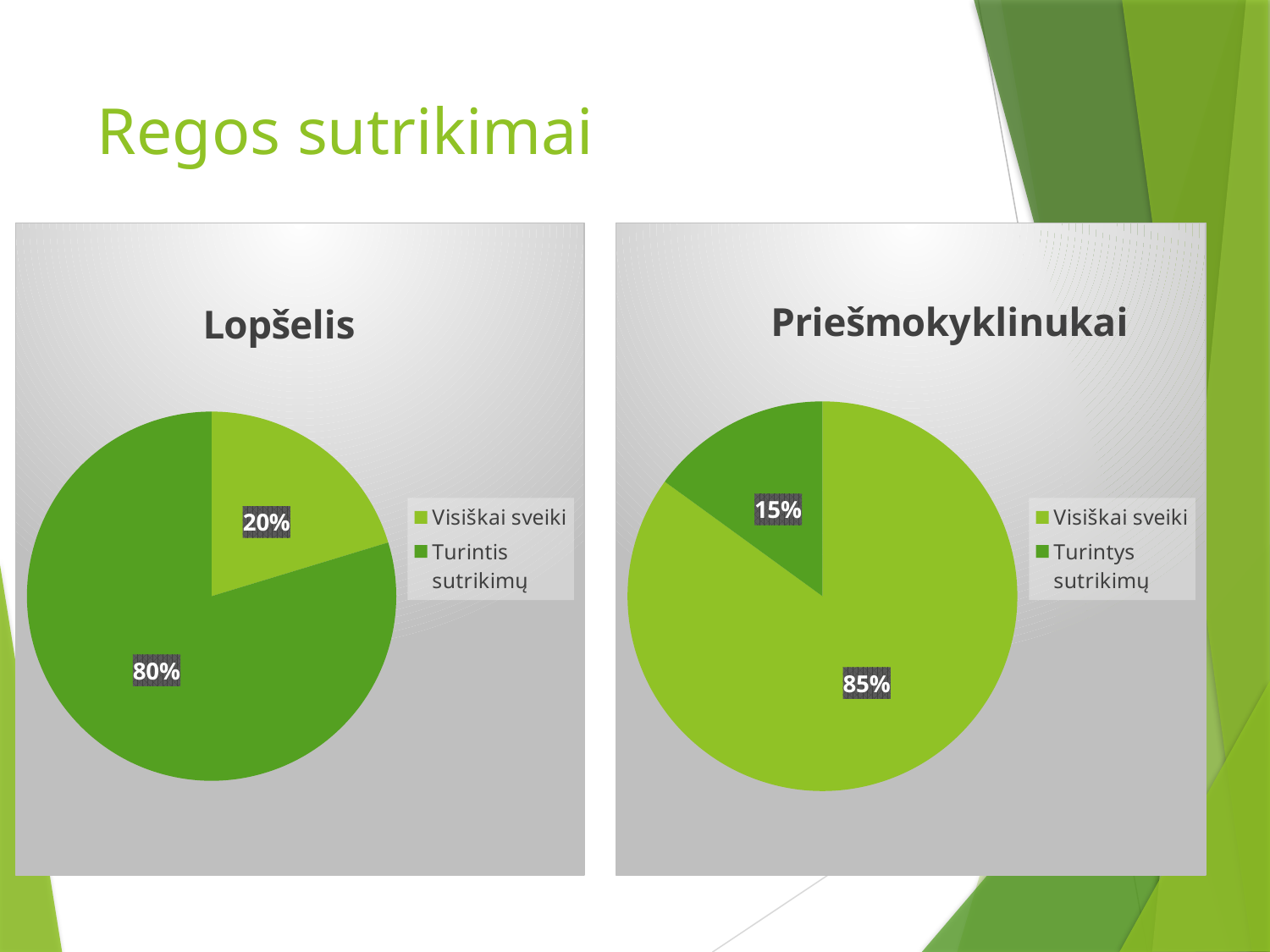
In the 'Priešmokyklinukai' chart, what percentage is shown for 'Turintys sutrikimų'? 15% Which is larger: 'Visiškai sveiki' in the 'Lopšelis' chart or 'Visiškai sveiki' in the 'Priešmokyklinukai' chart? Priešmokyklinukai What is the title of the slide? Regos sutrikimai How many slices does the 'Priešmokyklinukai' pie chart have? 2 What type of chart is the 'Lopšelis' chart? Pie chart In the 'Priešmokyklinukai' chart, which category has the smallest slice? Turintys sutrikimų In the 'Priešmokyklinukai' chart, what is the difference between the 'Visiškai sveiki' and 'Turintys sutrikimų' percentages? 70% In the 'Priešmokyklinukai' chart, what percentage is shown for 'Visiškai sveiki'? 85% In the 'Lopšelis' chart, what percentage is shown for 'Visiškai sveiki'? 20% In the 'Lopšelis' chart, which category has the largest slice? Turintis sutrikimų In the 'Lopšelis' chart, what percentage is shown for 'Turintis sutrikimų'? 80% In the 'Lopšelis' chart, what is the difference between the 'Turintis sutrikimų' and 'Visiškai sveiki' percentages? 60%